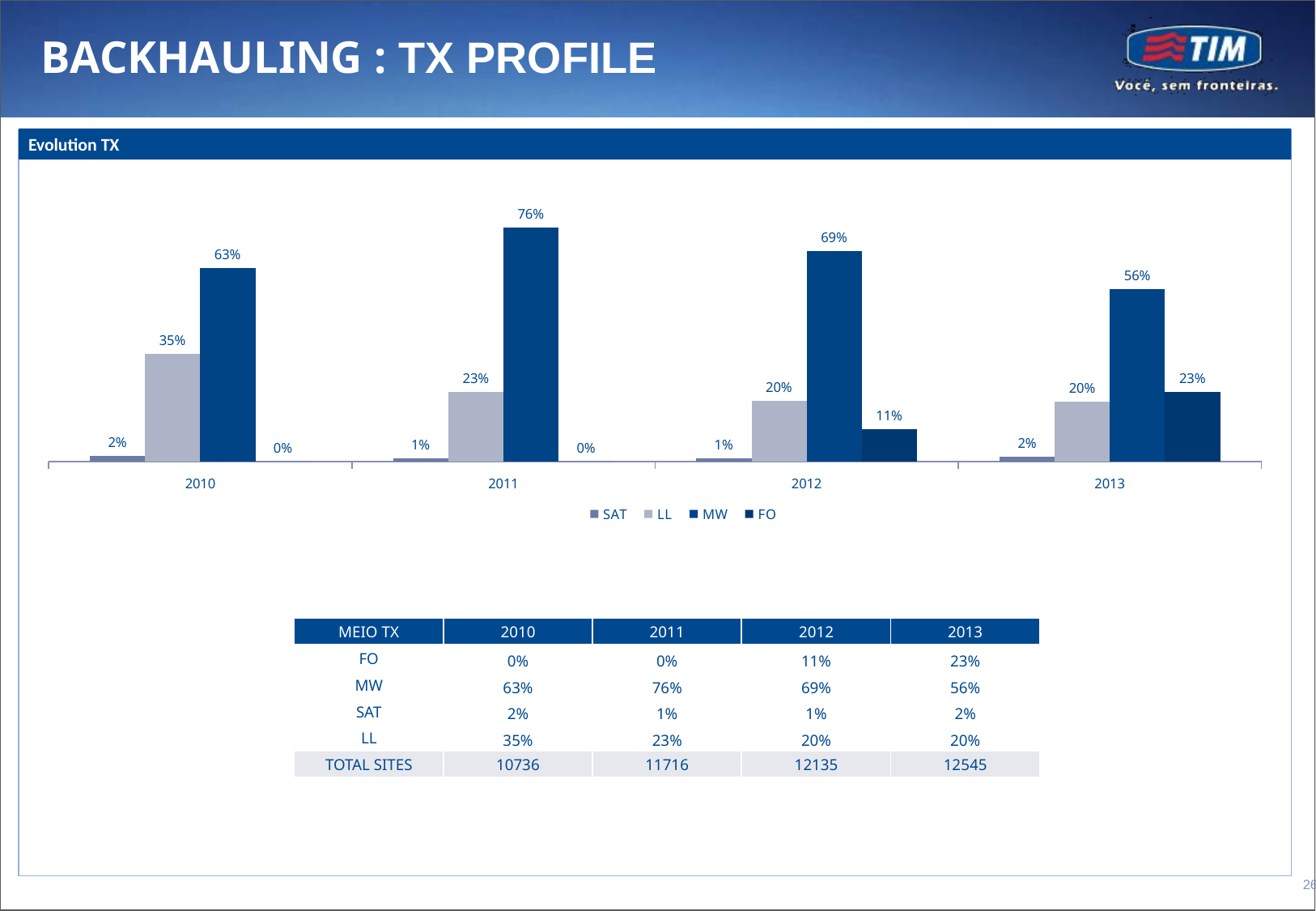
What kind of chart is shown? Bar chart Does the FO value rise or fall from 2011 to 2013? Rise What is the LL value for 2010? 35% What is the MW value for 2011? 76% What is the SAT value for 2012? 1% What is the FO value for 2013? 23% In which year is the LL value lowest? 2012 and 2013 (20%) Which is larger, the FO value for 2012 or the FO value for 2013? 2013 How many series does the legend list? 4 In which year is the MW value highest? 2011 How many years are shown on the x axis? 4 What is the difference between the MW values for 2011 and 2013? 20%